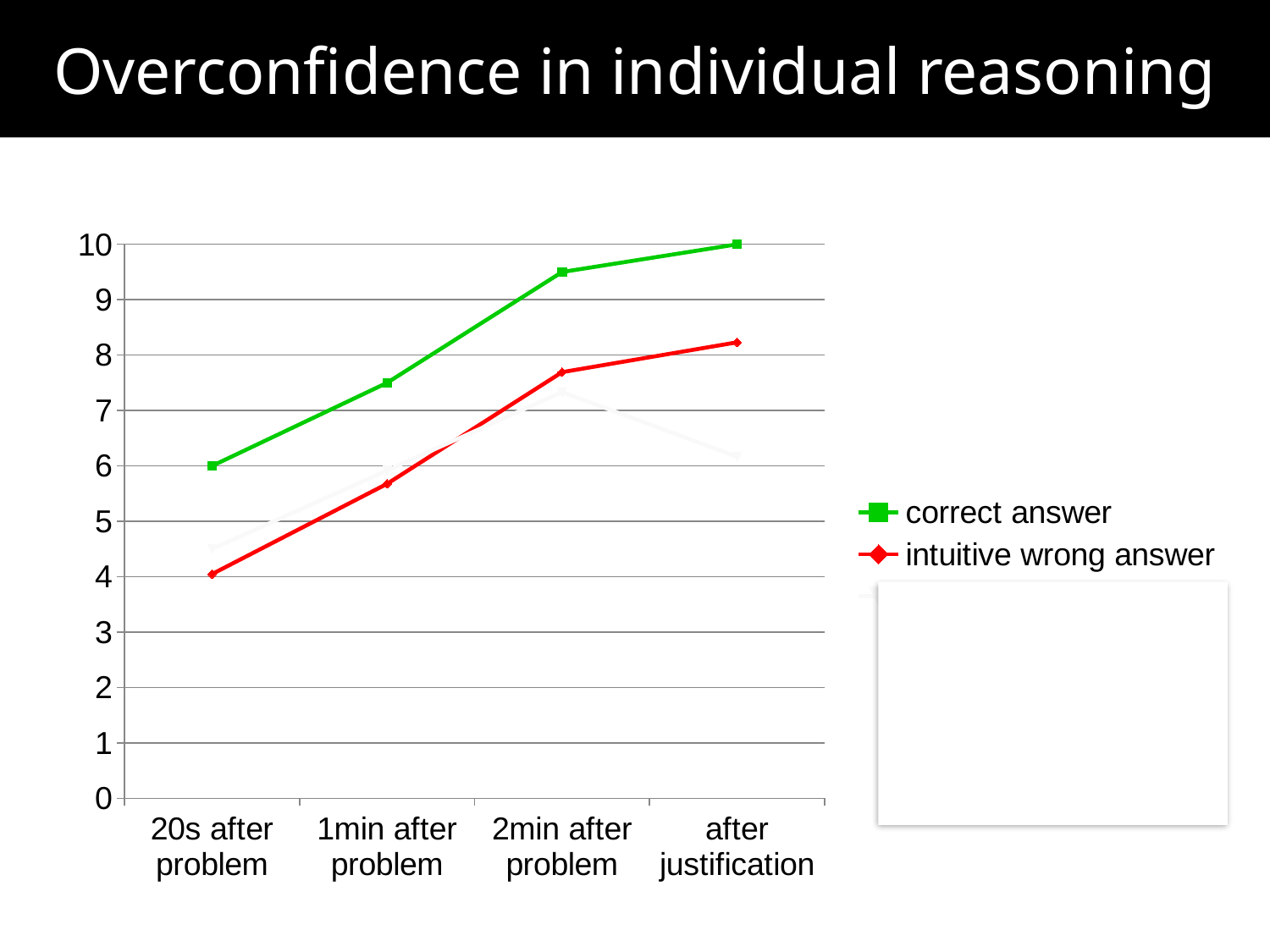
What kind of chart is shown on the slide? line chart What is the value for 'correct answer' at 'after justification'? 10 Which series has the larger value at '1min after problem', 'correct answer' or 'intuitive wrong answer'? correct answer At which category is the 'correct answer' series highest? after justification At which category is the 'intuitive wrong answer' series lowest? 20s after problem How many categories are shown on the x axis? 4 Is the value for 'intuitive wrong answer' at '1min after problem' greater or less than 5? greater How many series does the legend list? 2 Is the value for 'correct answer' at '2min after problem' greater or less than 9? greater Do the values of the 'intuitive wrong answer' series rise or fall from left to right along the x axis? rise Is the value for 'intuitive wrong answer' at '2min after problem' greater or less than 8? less What is the value for 'correct answer' at '20s after problem'? 6